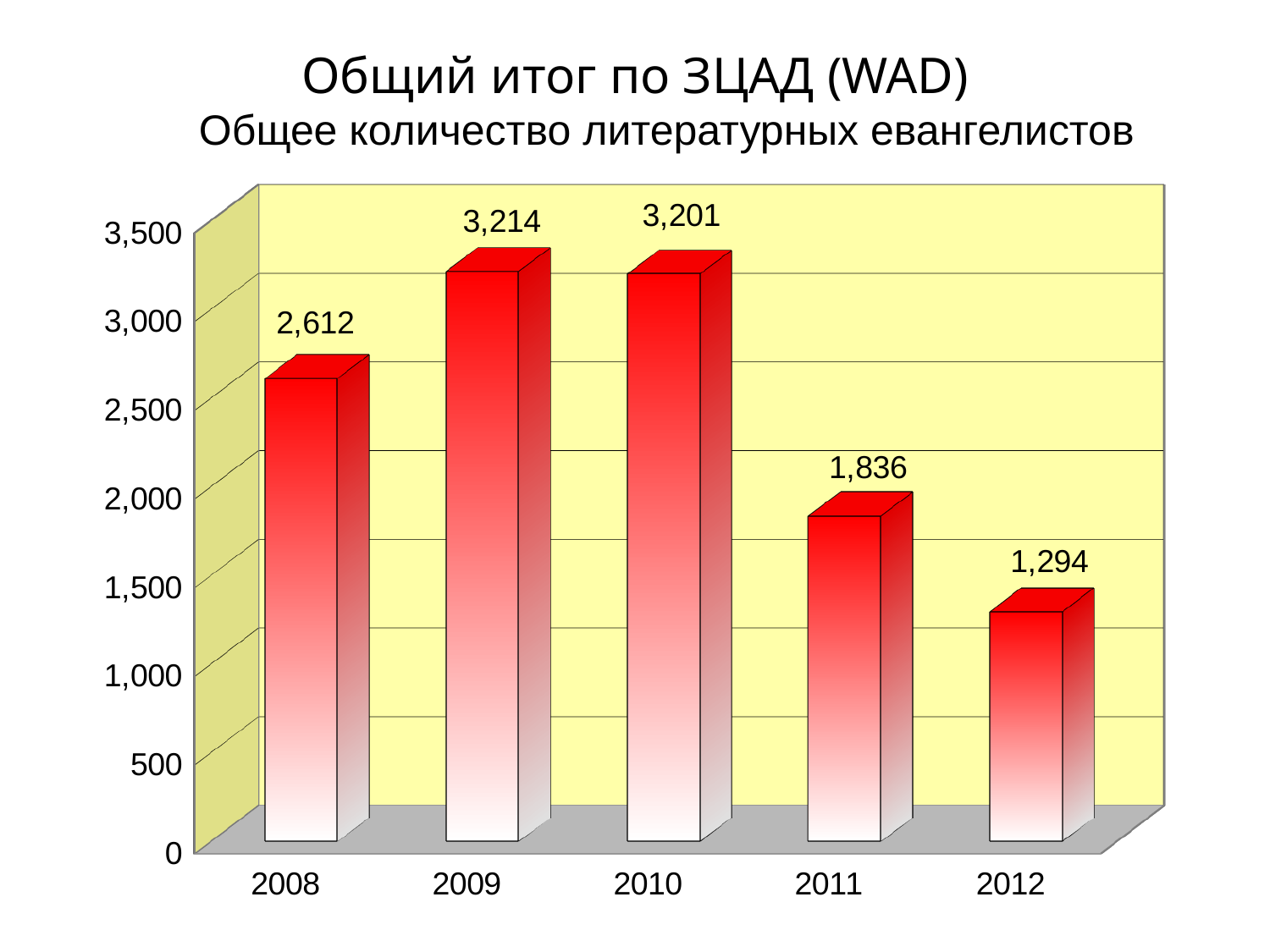
What is the value for 2011? 1,836 What is the value for 2008? 2,612 Which is larger, the value for 2008 or the value for 2011? 2008 What is the difference between the values for 2011 and 2012? 542 Is the value for 2010 greater or less than 3,000? greater What kind of chart is this? bar chart What is the difference between the values for 2009 and 2010? 13 Do the values rise or fall from 2010 to 2012? fall Which year has the highest value? 2009 What is the value for 2012? 1,294 Which year has the lowest value? 2012 How many years are shown on the x axis? 5